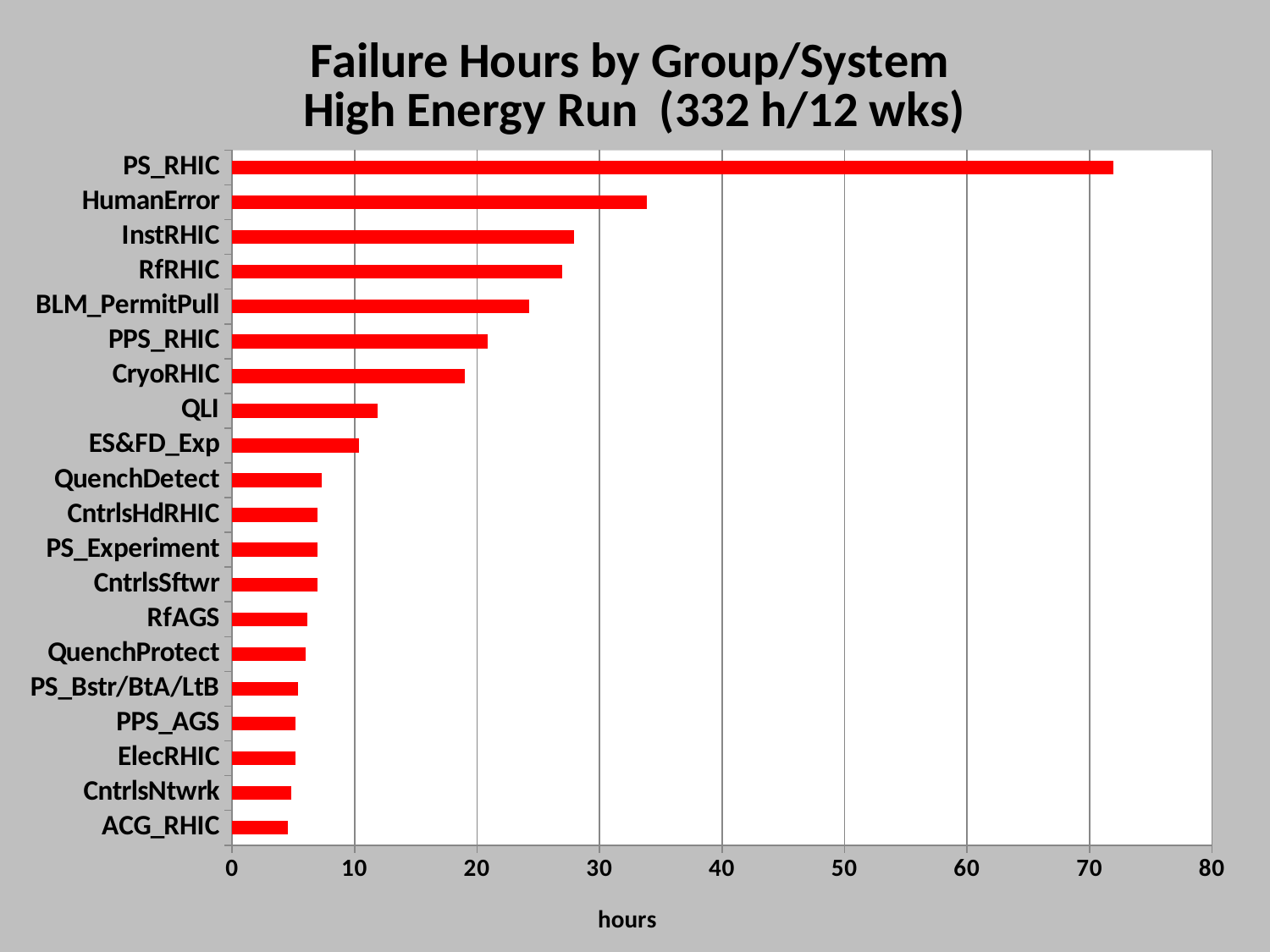
Is the value for InstRHIC greater or less than 30? less Is the value for BLM_PermitPull greater or less than 20? greater What is the label on the horizontal axis? hours Is the value for HumanError greater or less than 30? greater What kind of chart is shown on the slide? bar chart How many groups/systems are listed on the chart? 20 Which has more failure hours, CryoRHIC or QLI? CryoRHIC Which has more failure hours, HumanError or InstRHIC? HumanError Which group/system has the highest number of failure hours? PS_RHIC